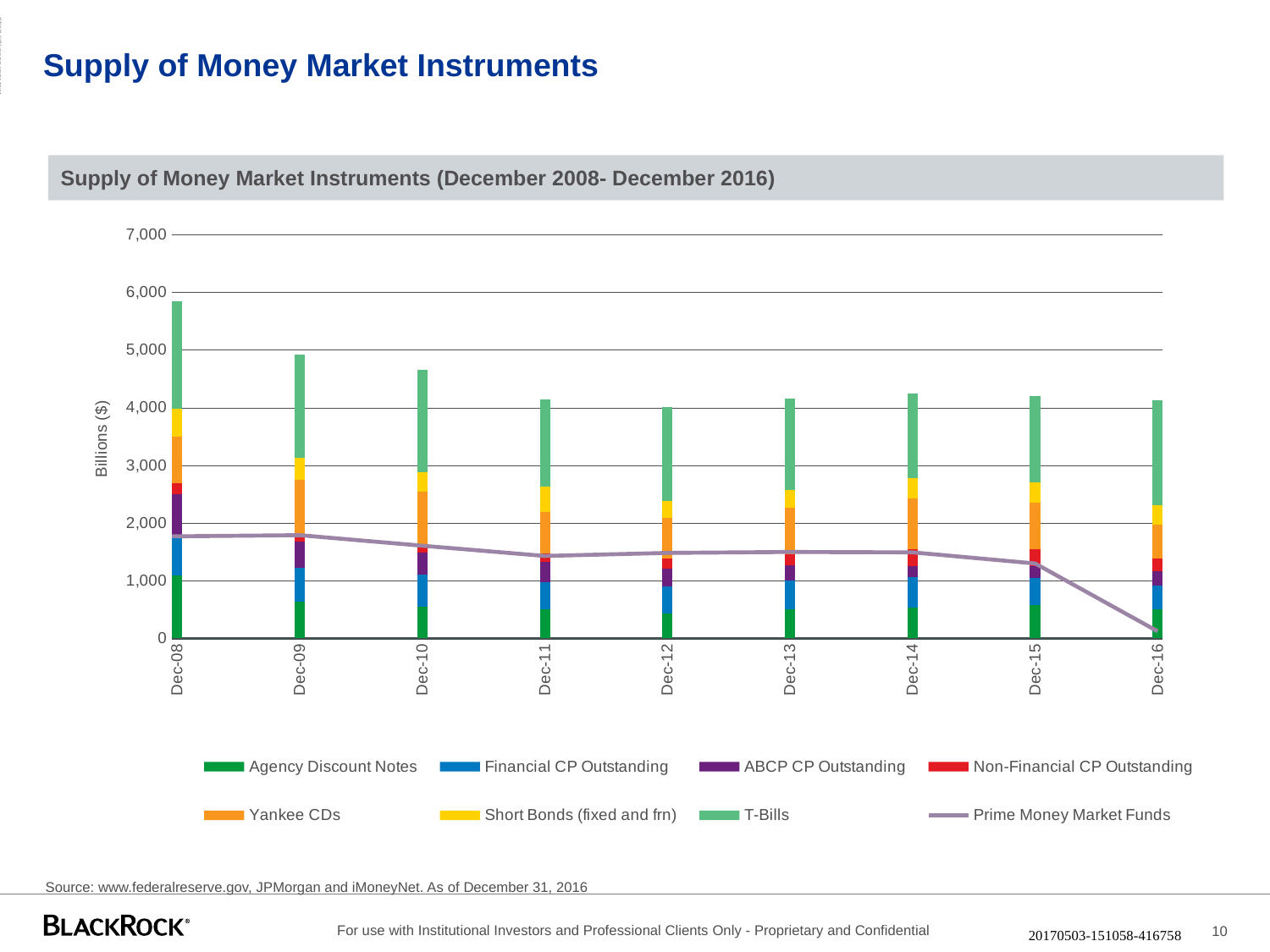
Is the value of Prime Money Market Funds at Dec-09 greater or less than 1,000? greater Is the value of Prime Money Market Funds at Dec-16 greater or less than 1,000? less Which is larger, the total stacked bar for Dec-08 or for Dec-16? Dec-08 Does the Prime Money Market Funds line rise or fall from Dec-08 to Dec-16? fall Which series is shown as a line rather than as bars? Prime Money Market Funds What kind of chart is shown on the slide? Stacked bar chart with a line How many series does the legend list? 8 Is the total stacked bar for Dec-08 greater or less than 5,000? greater Which date has the tallest stacked bar? Dec-08 How many dates (categories) are shown along the x axis? 9 What is the label on the y axis? Billions ($)